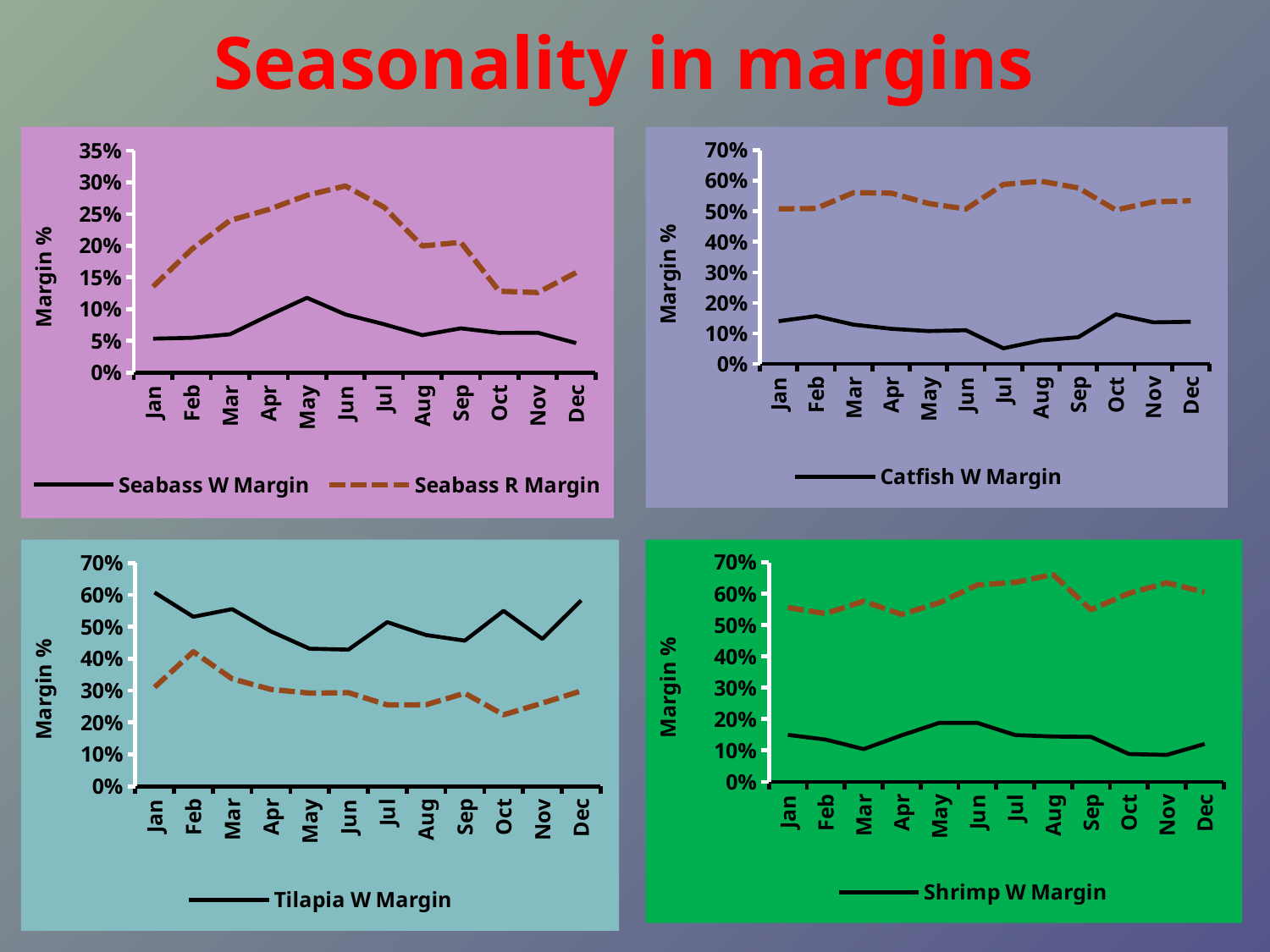
In the top-left chart, which month has the highest Seabass W Margin? May In the top-right chart, is the Catfish W Margin in Oct greater or less than 10%? greater In the top-left chart, is the Seabass R Margin in Jun greater or less than 25%? greater What kind of chart is the top-left chart? line chart In the bottom-left chart, is the Tilapia W Margin in Oct greater or less than 50%? greater What is the y-axis title of the bottom-right chart? Margin % In the top-left chart, does the Seabass R Margin rise or fall from Jun to Oct? fall How many charts are on the slide? 4 In the top-left chart, how many series does the legend list? 2 In the top-right chart, which month has the lowest Catfish W Margin? Jul In the top-left chart, which month has the highest Seabass R Margin? Jun